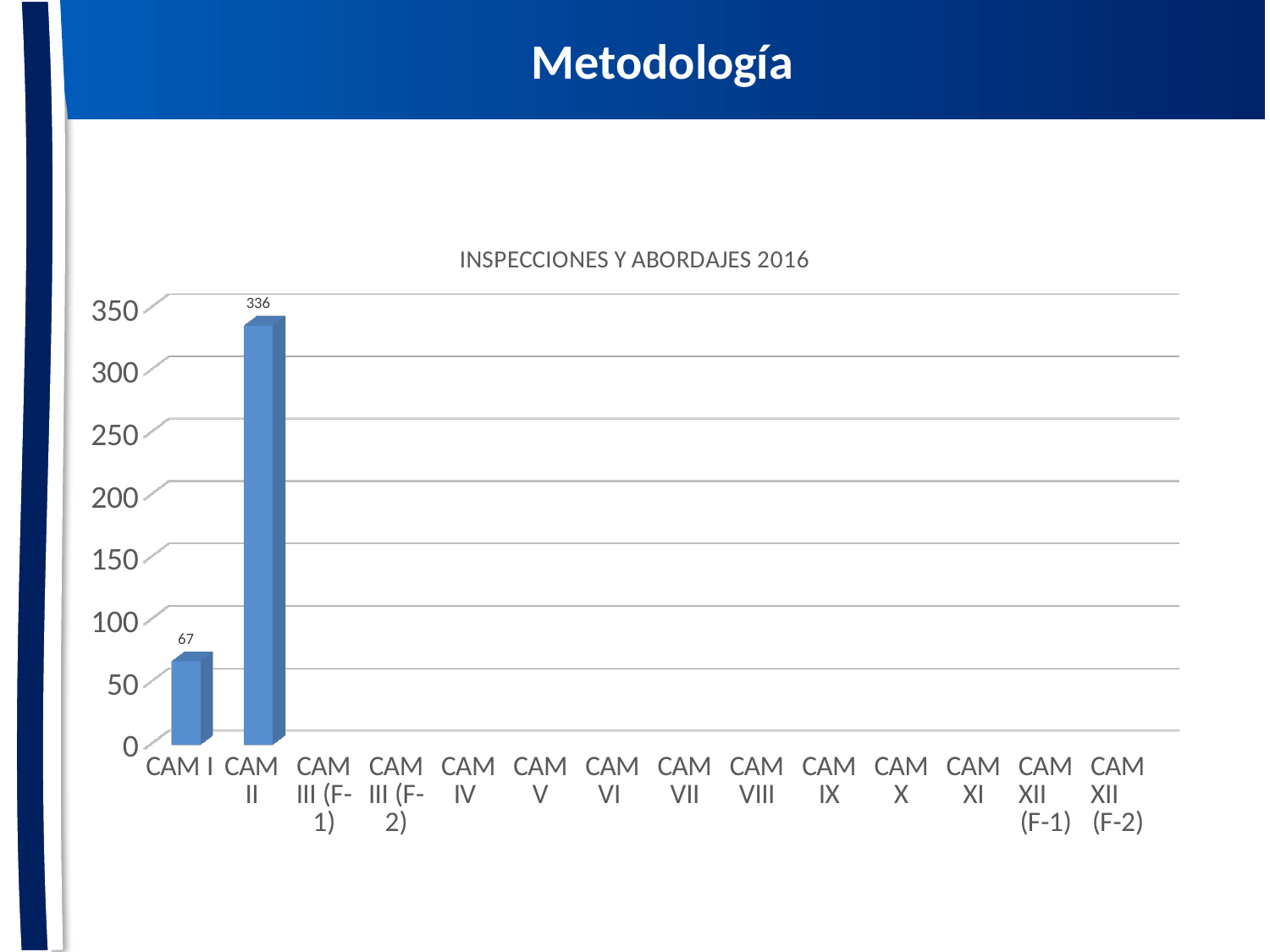
What is the value for CAM II? 336 How many categories have a visible bar with a data label? 2 What is the value for CAM I? 67 Is the value for CAM I greater or less than 100? less What kind of chart is shown on the slide? bar chart Which is larger, the value for CAM I or the value for CAM II? CAM II What is the difference between the values for CAM II and CAM I? 269 Is the value for CAM II greater or less than 300? greater How many categories are shown on the x axis? 14 What is the highest value shown on the y axis? 350 Which category has the highest value? CAM II What is the title of the chart? INSPECCIONES Y ABORDAJES 2016